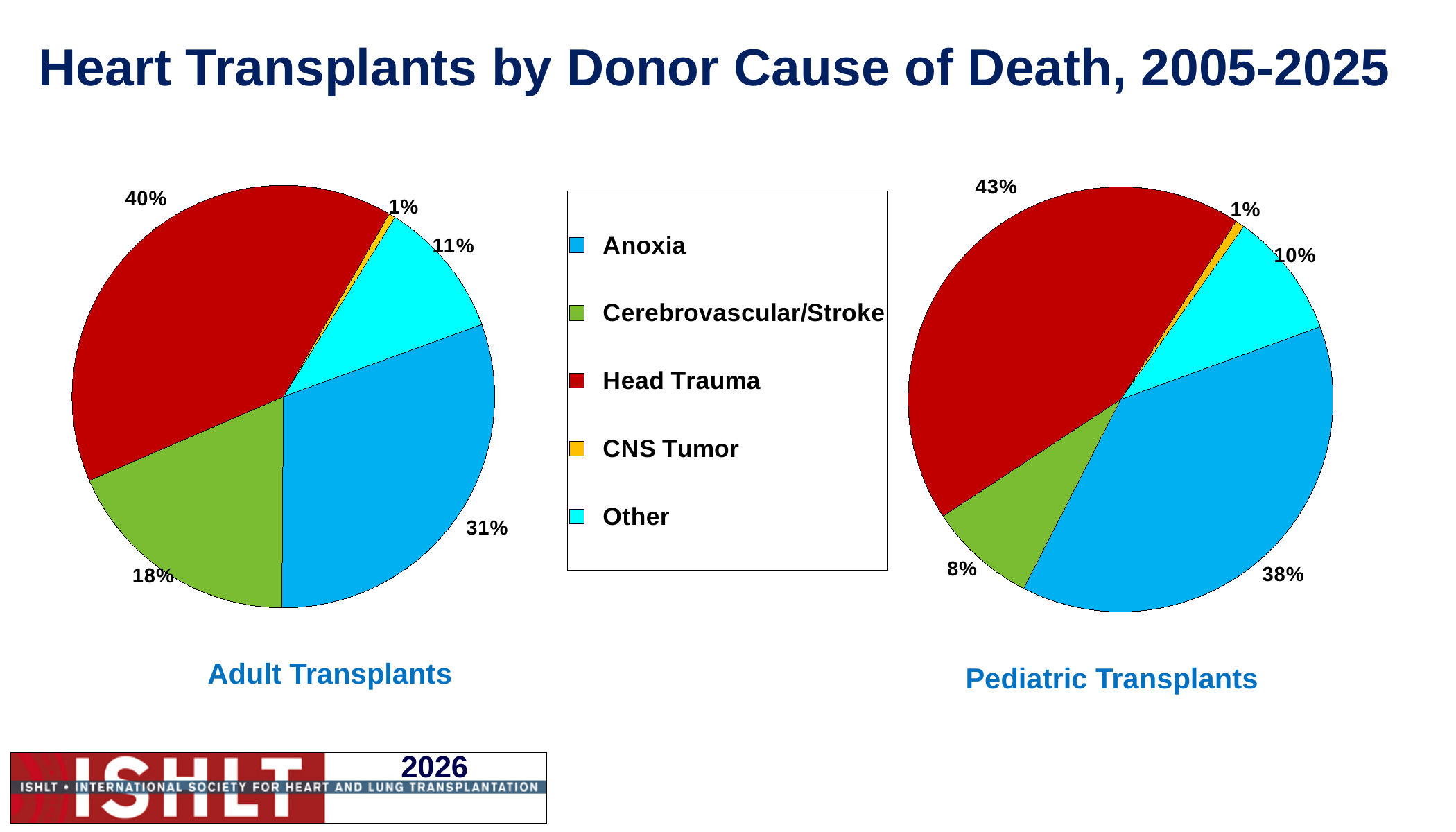
How many categories does the legend list? 5 What type of chart is used for Adult Transplants? Pie chart In the Adult Transplants pie chart, what is the difference between the Head Trauma share and the Anoxia share? 9% In the Adult Transplants pie chart, which cause of death has the largest share? Head Trauma What colour represents CNS Tumor in the legend? Yellow/orange In the Adult Transplants pie chart, what share is Cerebrovascular/Stroke? 18% In the Adult Transplants pie chart, what share of donors died from Head Trauma? 40% In the Pediatric Transplants pie chart, which cause of death has the smallest share? CNS Tumor Which chart has the larger Cerebrovascular/Stroke share, Adult Transplants or Pediatric Transplants? Adult Transplants In the Pediatric Transplants pie chart, what is the difference between the Anoxia share and the Cerebrovascular/Stroke share? 30% In the Pediatric Transplants pie chart, what share is Other? 10%